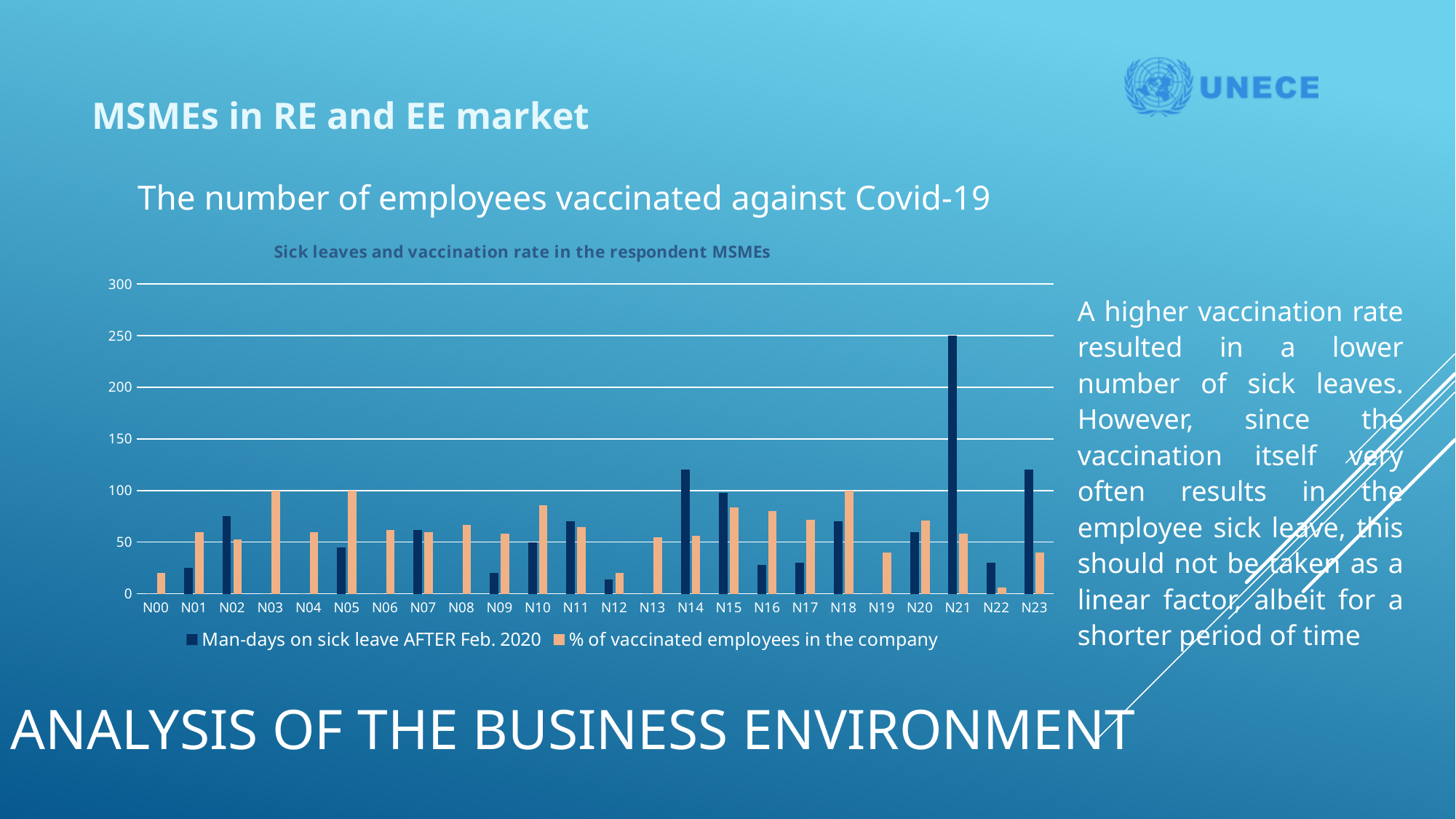
Which category has the highest value for Man-days on sick leave AFTER Feb. 2020? N21 What is the % of vaccinated employees in the company for N03? 100 Which has more Man-days on sick leave AFTER Feb. 2020, N14 or N01? N14 What is the value of Man-days on sick leave AFTER Feb. 2020 for N21? 250 How many categories (respondent MSMEs) are shown on the x axis? 24 Is the value of Man-days on sick leave AFTER Feb. 2020 for N12 greater or less than 50? less Which category has the lowest value for % of vaccinated employees in the company? N22 How many series does the chart legend list? 2 Which colour represents % of vaccinated employees in the company in the chart? orange What is the title of the chart? Sick leaves and vaccination rate in the respondent MSMEs Is the value of Man-days on sick leave AFTER Feb. 2020 for N14 greater or less than 100? greater What type of chart is shown on the slide? bar chart